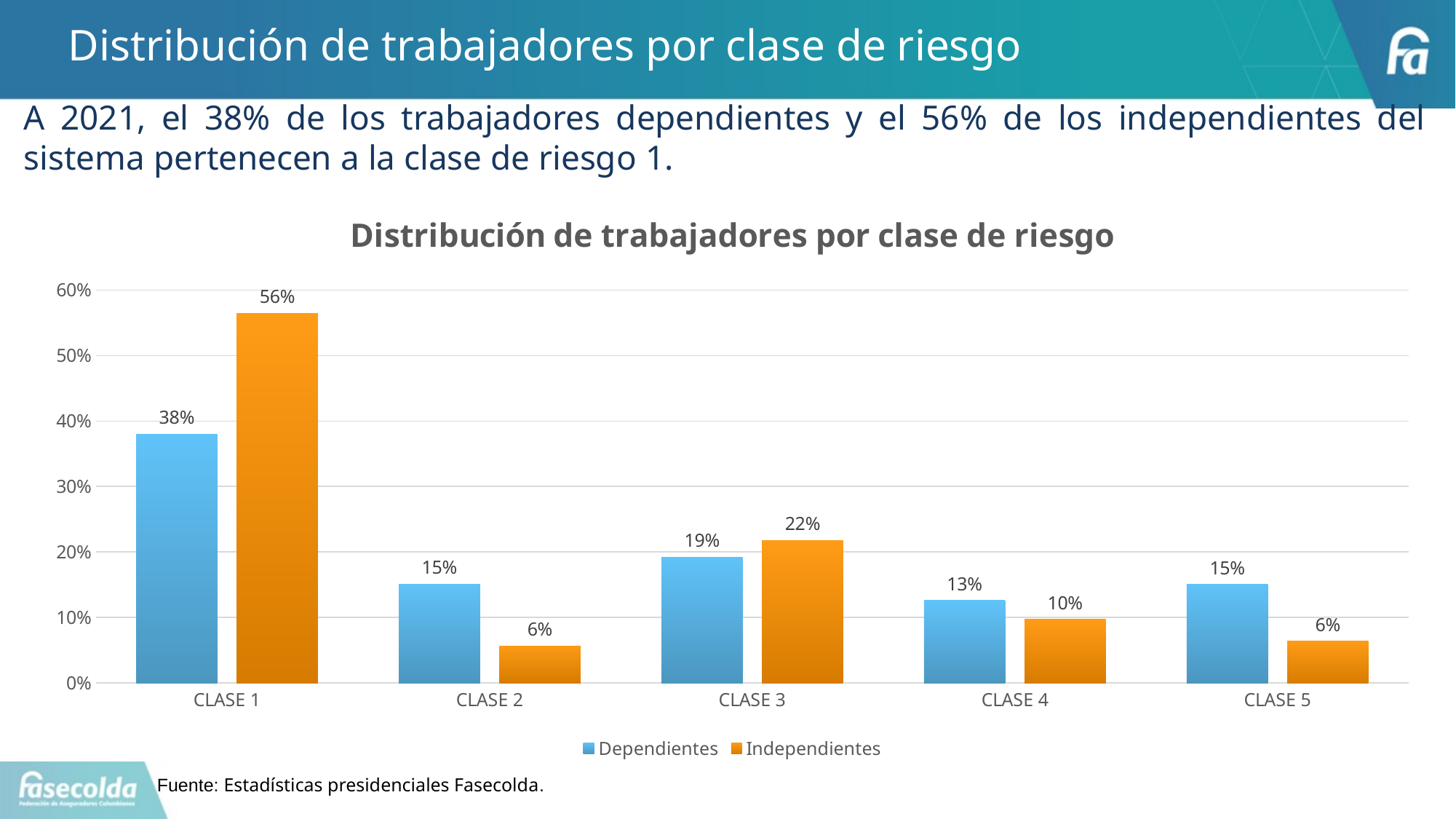
Which is larger in CLASE 2, Dependientes or Independientes? Dependientes Which category has the highest value for Independientes? CLASE 1 Which category has the lowest value for Dependientes? CLASE 4 What colour represents the Independientes series? Orange What is the difference between Independientes and Dependientes in CLASE 1? 18% How many series does the legend list? 2 Is the value for Independientes in CLASE 1 greater or less than 50%? greater What is the value for Independientes in CLASE 3? 22% What kind of chart is shown on the slide? Bar chart How many categories are shown on the x axis? 5 What is the value for Independientes in CLASE 5? 6% What is the value for Dependientes in CLASE 1? 38%